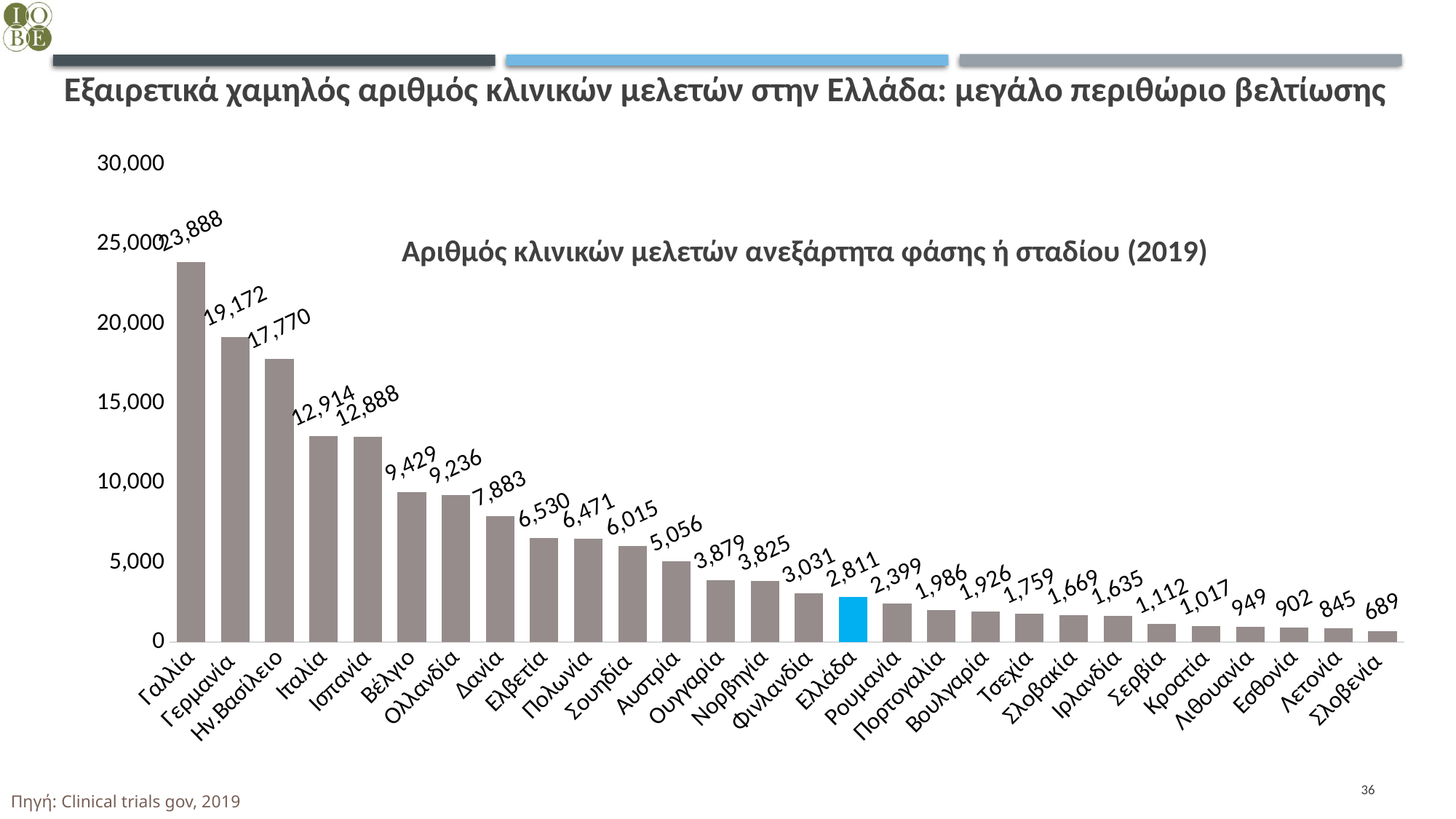
What is the difference between the values for Ελλάδα and Ρουμανία? 412 Which is larger, the value for Βέλγιο or the value for Δανία? Βέλγιο What is the value for Πολωνία? 6,471 Which country has the lowest number of clinical trials? Σλοβενία Which country's bar is highlighted in blue? Ελλάδα What is the value for Γερμανία? 19,172 Which country has the highest number of clinical trials? Γαλλία What kind of chart is shown on the slide? bar chart How many countries are shown in the chart? 28 What is the value for Ελλάδα? 2,811 What is the difference between the values for Γαλλία and Γερμανία? 4,716 Is the value for Ην.Βασίλειο greater or less than 15,000? greater